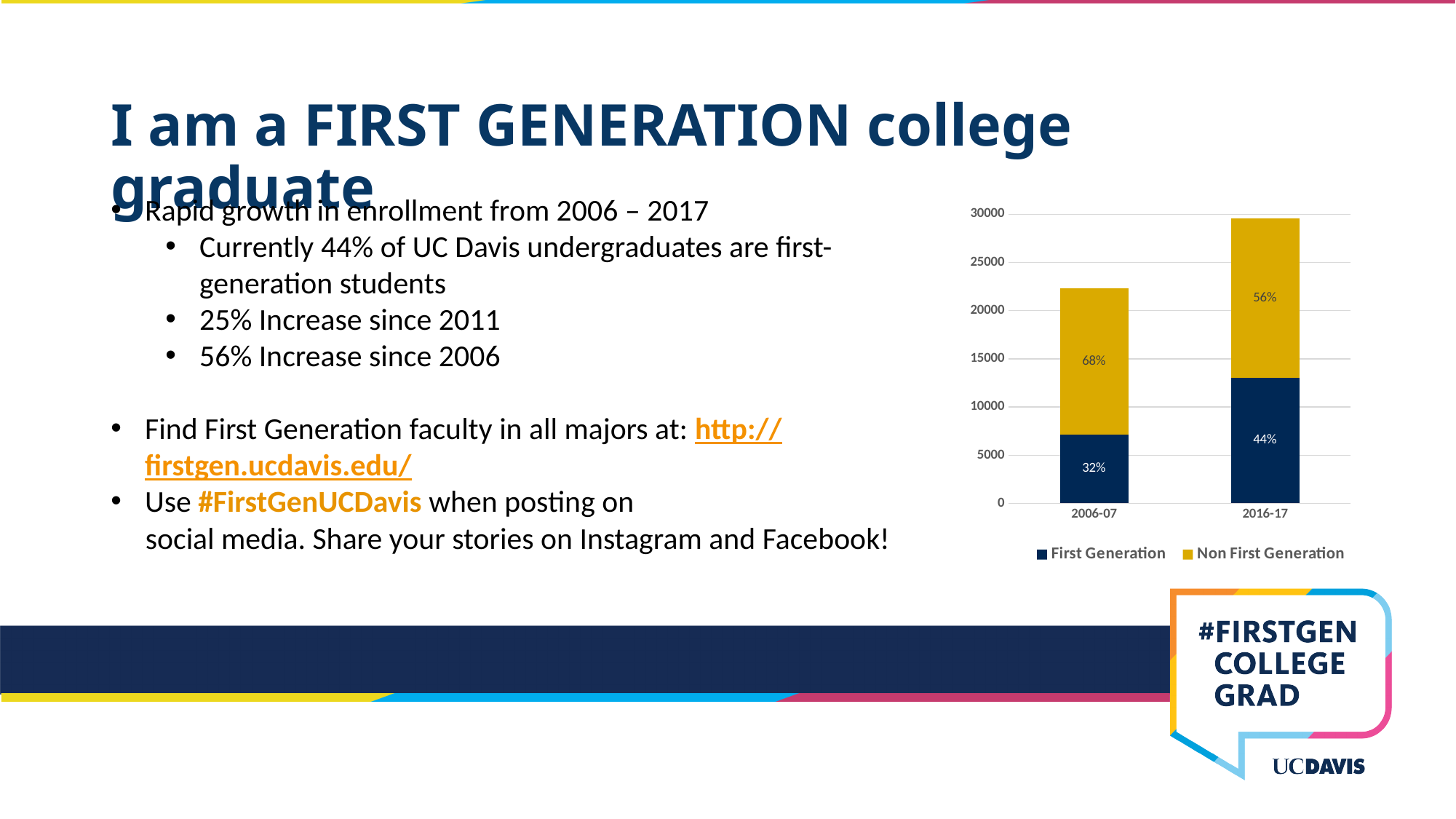
Is the total height of the 2016-17 bar greater or less than 25000? greater What data label is shown on the First Generation segment of the 2016-17 bar? 44% Which year has the taller total bar, 2006-07 or 2016-17? 2016-17 Is the total height of the 2006-07 bar greater or less than 25000? less How many categories are shown on the x axis of the chart? 2 What data label is shown on the Non First Generation segment of the 2016-17 bar? 56% What kind of chart is shown on the slide? Stacked bar chart How many series does the chart legend list? 2 Which colour represents the First Generation series in the chart? Dark blue What data label is shown on the Non First Generation segment of the 2006-07 bar? 68% By how many percentage points does the Non First Generation label exceed the First Generation label in the 2006-07 bar? 36% What data label is shown on the First Generation segment of the 2006-07 bar? 32%